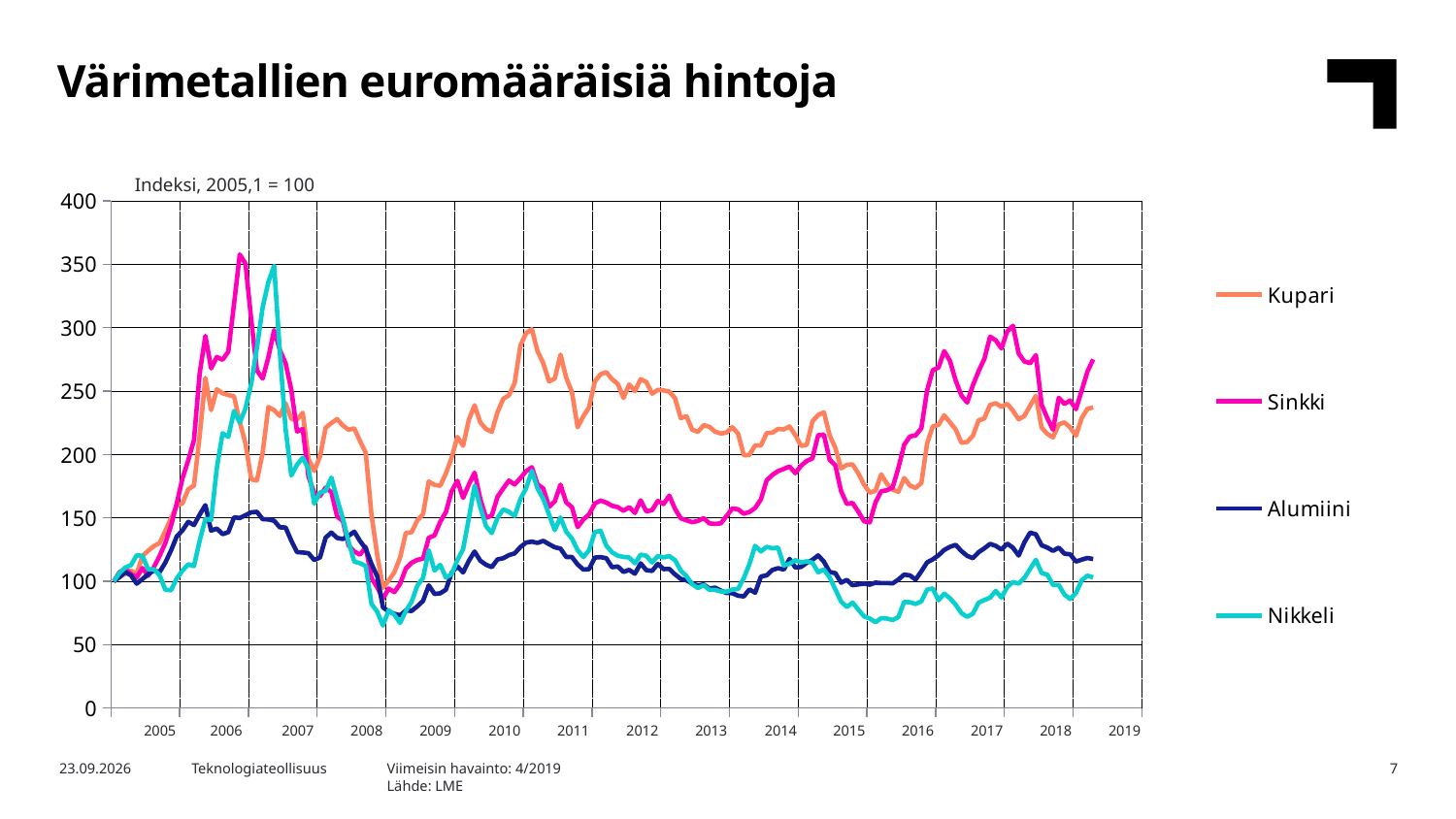
Does the Nikkeli line rise or fall from 2007 to 2008? fall Is the peak value of Sinkki in 2006 greater or less than 300? greater Is the peak value of Kupari in 2010 greater or less than 250? greater What index base is stated above the chart's y axis? Indeksi, 2005,1 = 100 Is the highest value reached by Alumiini greater or less than 200? less What type of chart is shown on the slide? line chart What is the title of the chart? Värimetallien euromääräisiä hintoja Which series has the highest value at the right end of the chart (2019)? Sinkki At the start of 2019, is the value for Sinkki or Kupari larger? Sinkki How many series does the legend list? 4 Which series has the lowest value at the right end of the chart (2019)? Nikkeli